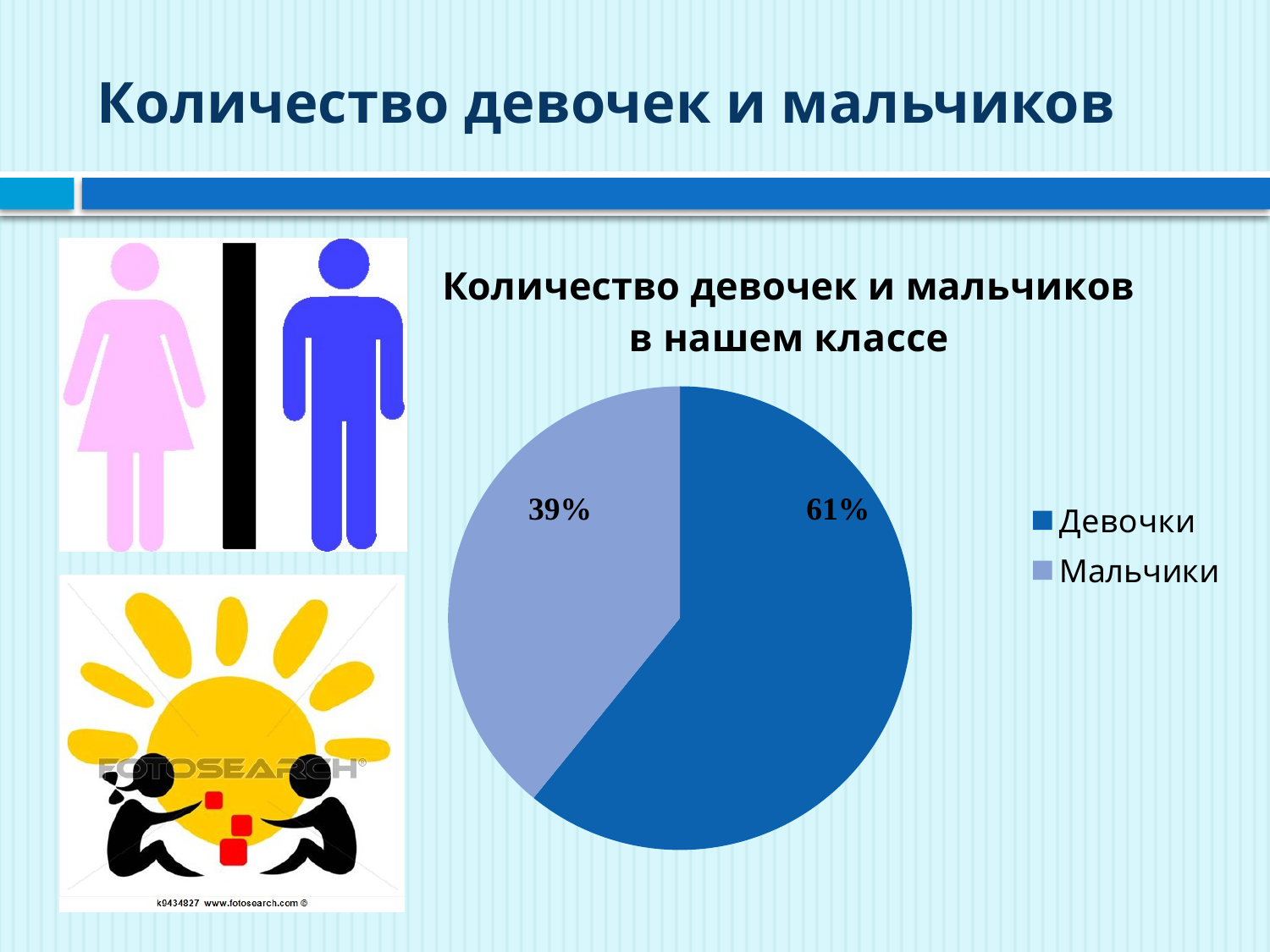
Is the share for Мальчики greater or less than 50%? less Which legend entry is shown in the darker blue colour? Девочки How many entries does the legend list? 2 What is the title of the chart? Количество девочек и мальчиков в нашем классе Which category has the smallest slice of the pie? Мальчики What is the difference in percentage points between Девочки and Мальчики? 22% Which is larger, the share for Девочки or the share for Мальчики? Девочки How many categories does the pie chart have? 2 What share of the pie is Девочки? 61% Which category has the largest slice of the pie? Девочки What kind of chart is shown on the slide? pie chart What share of the pie is Мальчики? 39%